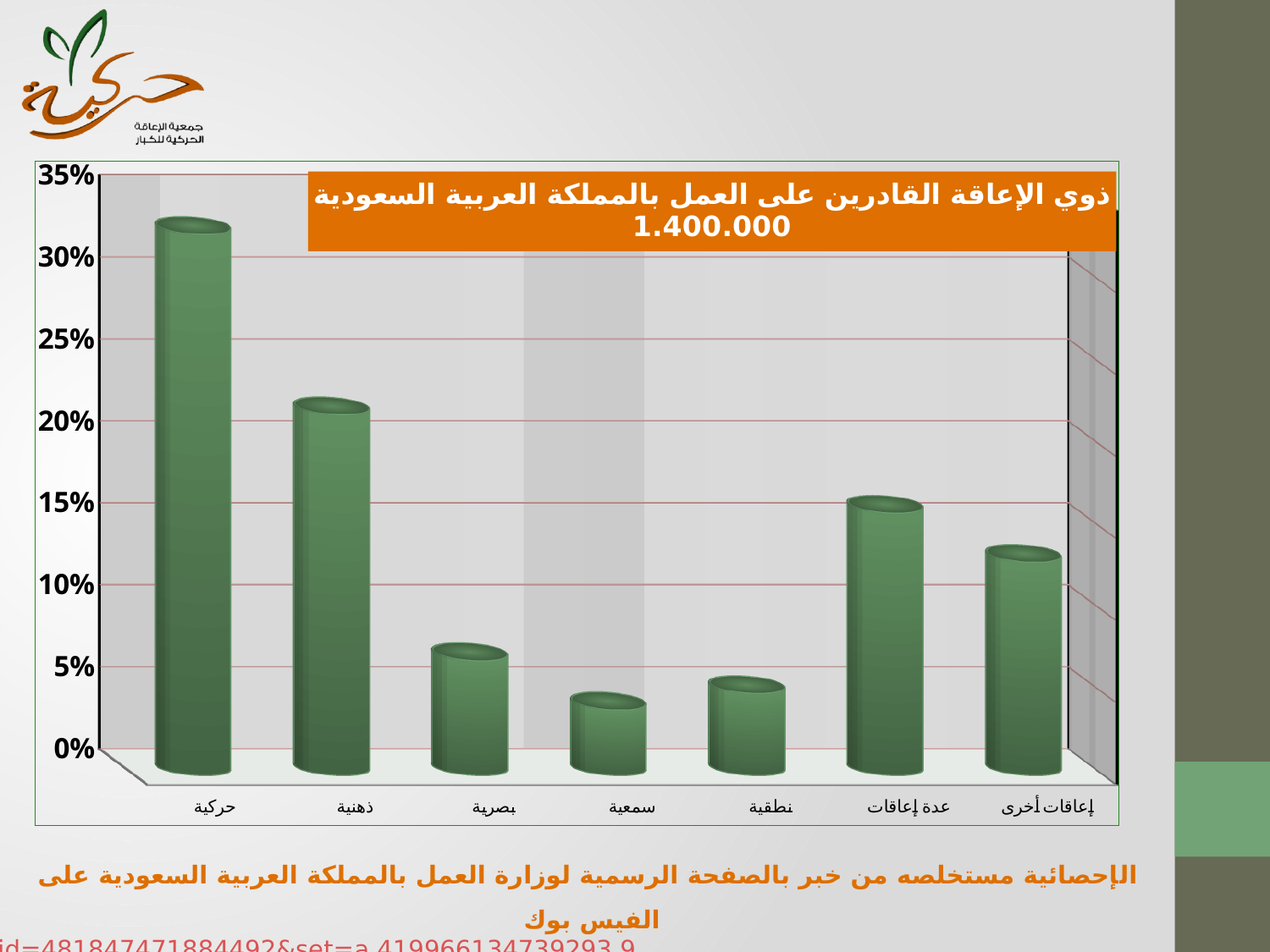
How many categories are shown on the x axis of the chart? 7 Is the value for ذهنية greater or less than 15%? greater Which category has the highest value in the chart? حركية Is the value for سمعية greater or less than 5%? less What number appears in the chart title below the text 'ذوي الإعاقة القادرين على العمل بالمملكة العربية السعودية'? 1.400.000 Is the value for إعاقات أخرى greater or less than 10%? greater What kind of chart is shown on the slide? bar chart Which is larger, the value for ذهنية or the value for عدة إعاقات? ذهنية Which is larger, the value for عدة إعاقات or the value for إعاقات أخرى? عدة إعاقات